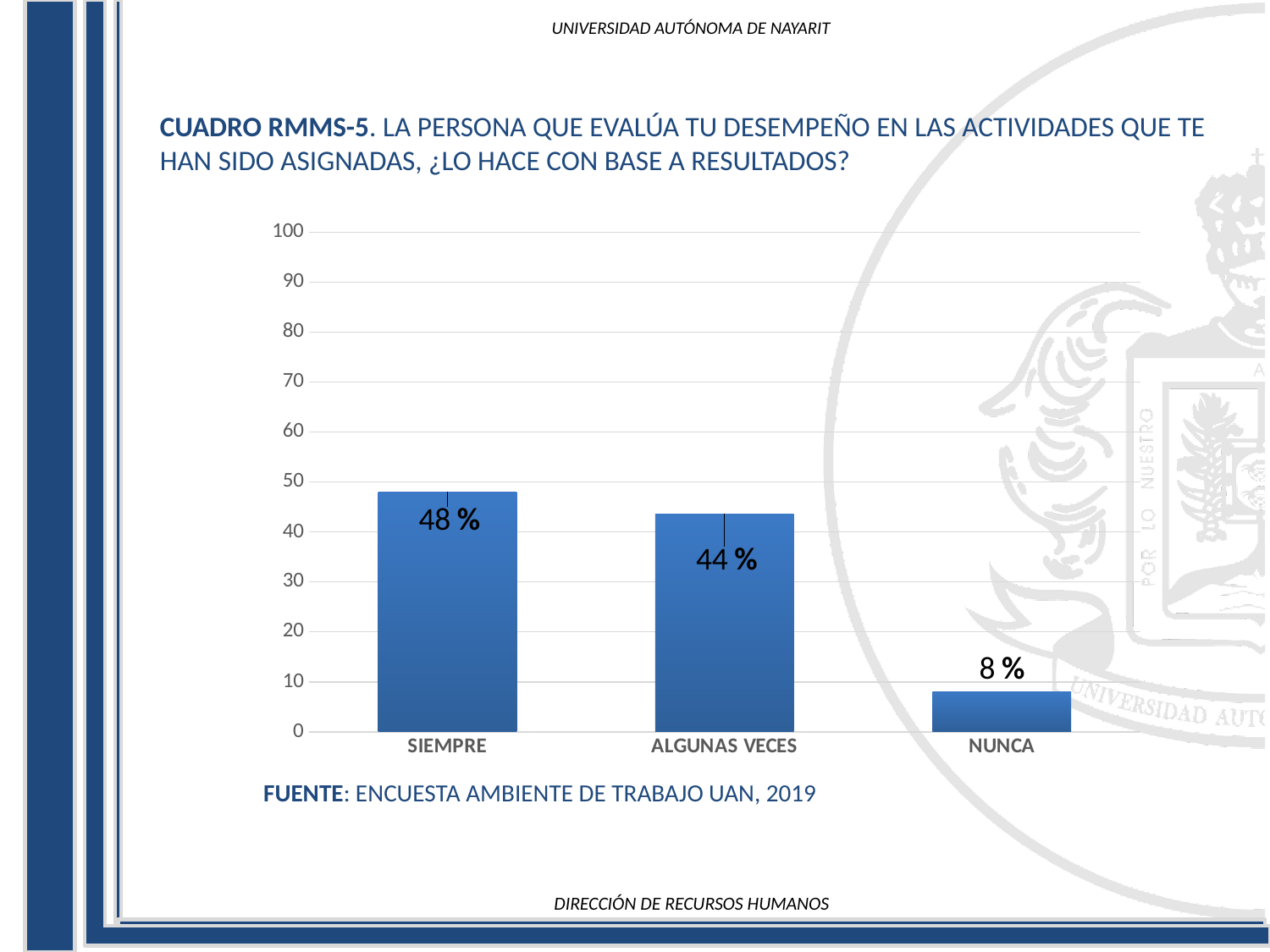
Is the value for ALGUNAS VECES greater or less than 50? less Which is larger, the value for SIEMPRE or the value for NUNCA? SIEMPRE What is the difference between the values for ALGUNAS VECES and NUNCA? 36 % Which category has the highest value? SIEMPRE What is the value for NUNCA? 8 % Do the values rise or fall from left to right along the x axis? fall What is the value for SIEMPRE? 48 % How many categories are shown on the x axis? 3 What kind of chart is shown on the slide? bar chart What is the value for ALGUNAS VECES? 44 % What is the difference between the values for SIEMPRE and ALGUNAS VECES? 4 % Which category has the lowest value? NUNCA